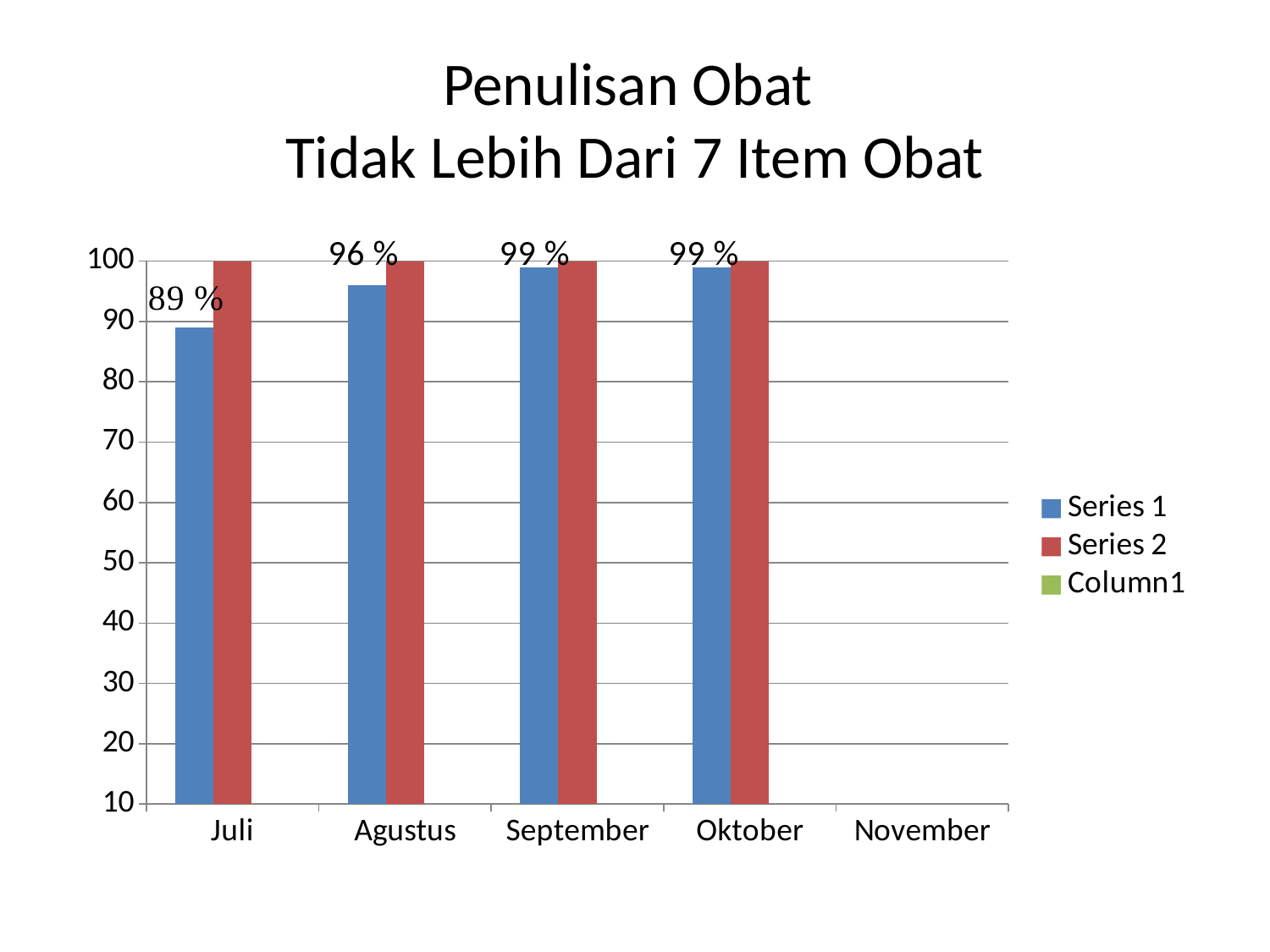
Which month has the lowest Series 1 value? Juli What is the value of Series 1 for Agustus? 96 % How many series does the legend list? 3 What is the value of Series 1 for Juli? 89 % Which is larger, the Series 1 value for Juli or for Agustus? Agustus What is the difference between the Series 1 values for Agustus and Juli? 7 % What value does the Series 2 bar for Juli reach on the axis? 100 What is the value of Series 1 for Oktober? 99 % What kind of chart is shown on the slide? bar chart Is the Series 1 value for Juli greater or less than 90? less How many months are listed on the x axis? 5 Do the Series 1 values rise or fall from Juli to Oktober? rise